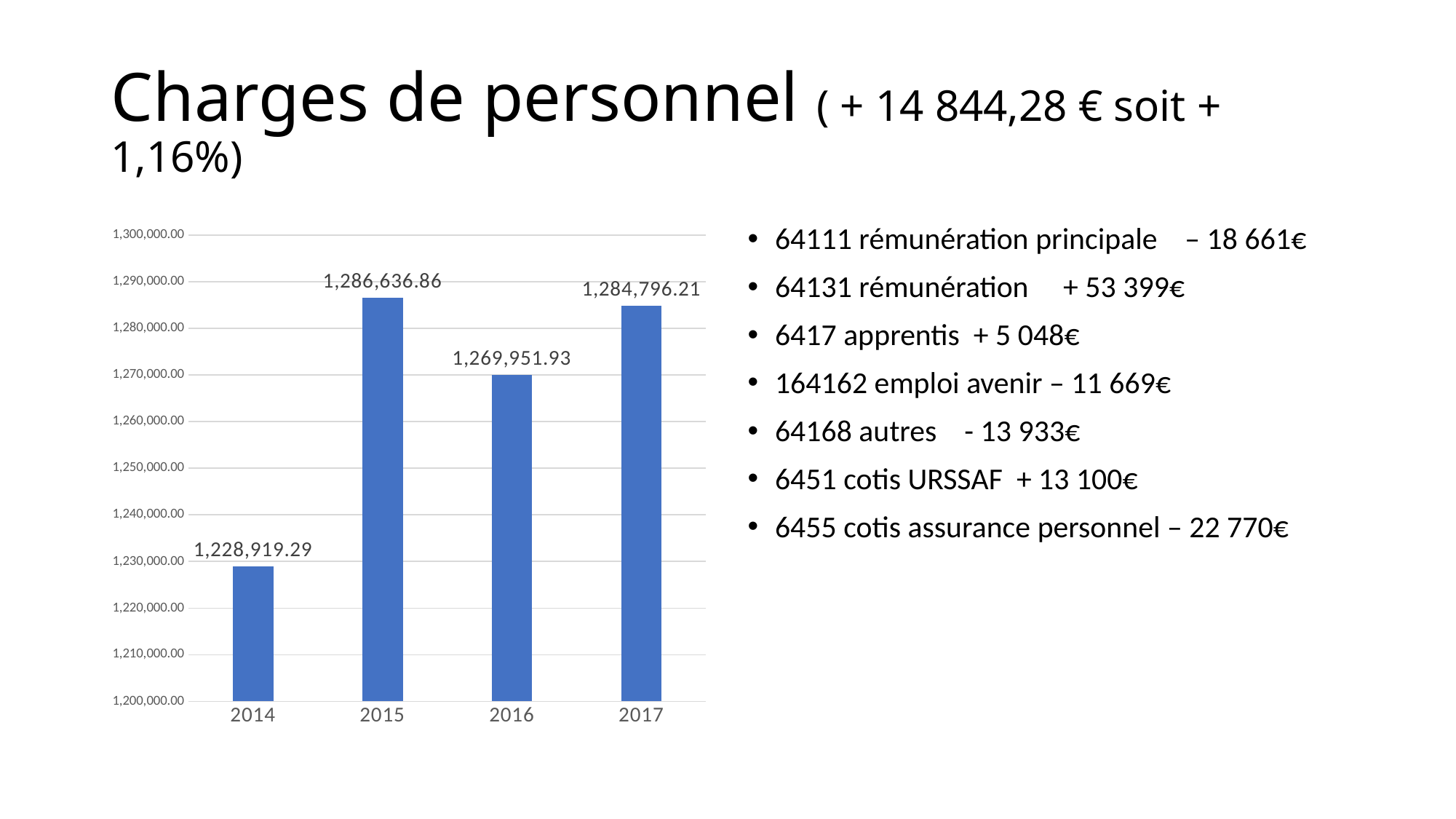
What is the difference between the values for 2015 and 2014? 57,717.57 What is the value for 2017? 1,284,796.21 What is the value for 2016? 1,269,951.93 What is the difference between the values for 2017 and 2016? 14,844.28 Which year has the highest value? 2015 Which year has the lowest value? 2014 What colour are the bars in the chart? blue Which is larger, the value for 2016 or the value for 2017? 2017 Is the value for 2014 greater or less than 1,230,000.00? less What kind of chart is shown on the slide? bar chart How many years are shown on the x axis? 4 What is the value for 2014? 1,228,919.29